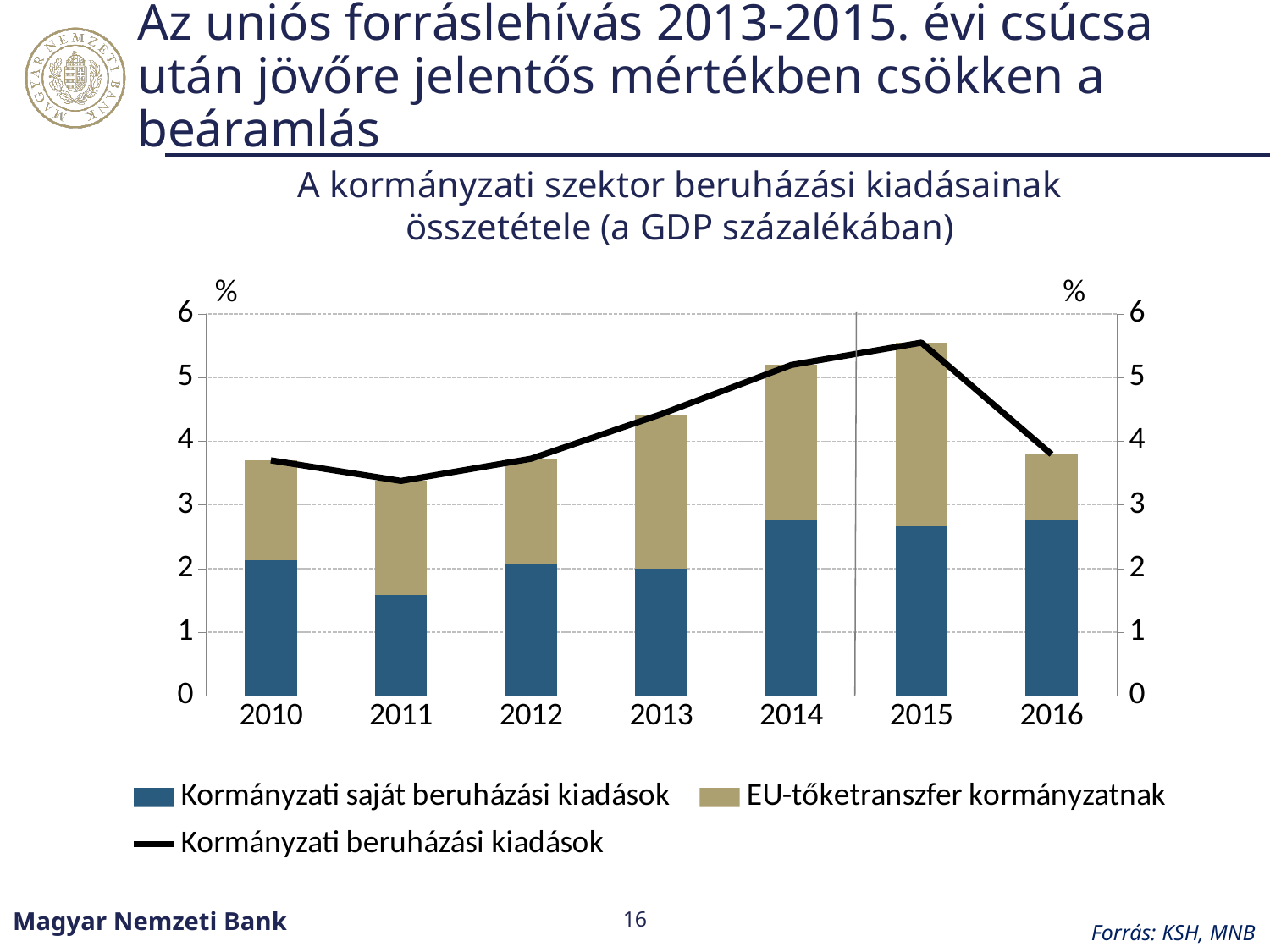
Which year has the larger total government investment expenditure, 2013 or 2016? 2013 Which legend entry is shown as a black line? Kormányzati beruházási kiadások Does the total government investment expenditure rise or fall from 2011 to 2015? rise What kind of chart is shown on the slide? Stacked bar chart with a line Is the total government investment expenditure in 2014 greater or less than 5%? greater Is the total government investment expenditure in 2016 greater or less than 4%? less In which year is the total government investment expenditure (Kormányzati beruházási kiadások) lowest? 2011 In which year is the total government investment expenditure (Kormányzati beruházási kiadások) highest? 2015 How many series does the legend list? 3 Is the value of Kormányzati saját beruházási kiadások in 2011 greater or less than 2%? less How many years are shown on the x axis of the chart? 7 What is the title of the chart? A kormányzati szektor beruházási kiadásainak összetétele (a GDP százalékában)